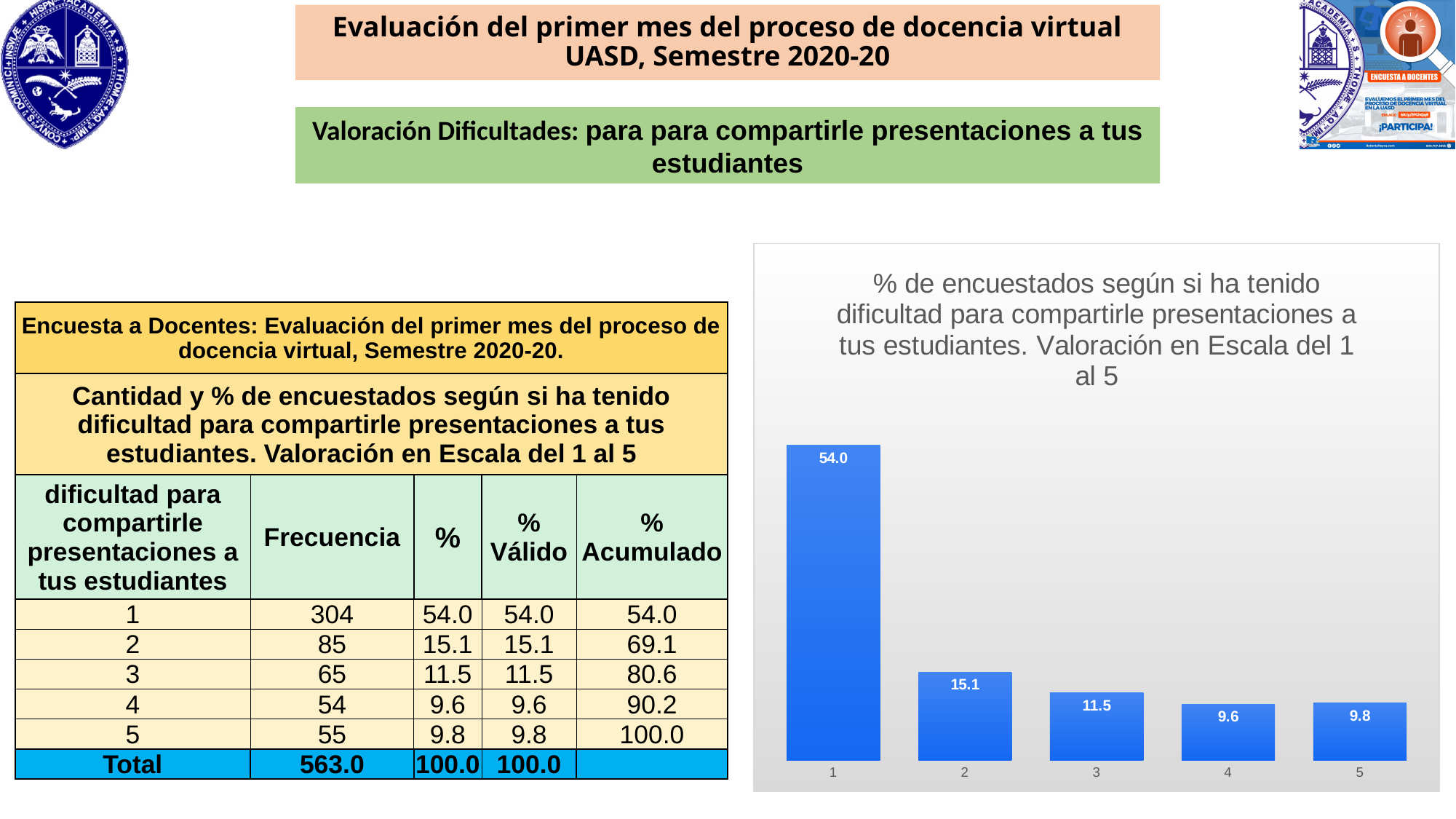
Which category has the lowest value in the chart? 4 What is the title of the chart? % de encuestados según si ha tenido dificultad para compartirle presentaciones a tus estudiantes. Valoración en Escala del 1 al 5 Do the values in the chart generally rise or fall from category 1 to category 4? fall What is the difference between the values for category 1 and category 2 in the chart? 38.9 What kind of chart is shown on the slide? bar chart What is the difference between the values for category 2 and category 3 in the chart? 3.6 Which is larger in the chart, the value for category 2 or the value for category 3? 2 What is the value for category 5 in the chart? 9.8 How many categories are shown on the x axis of the chart? 5 Which category has the highest value in the chart? 1 What is the value for category 3 in the chart? 11.5 What is the value for category 1 in the chart? 54.0